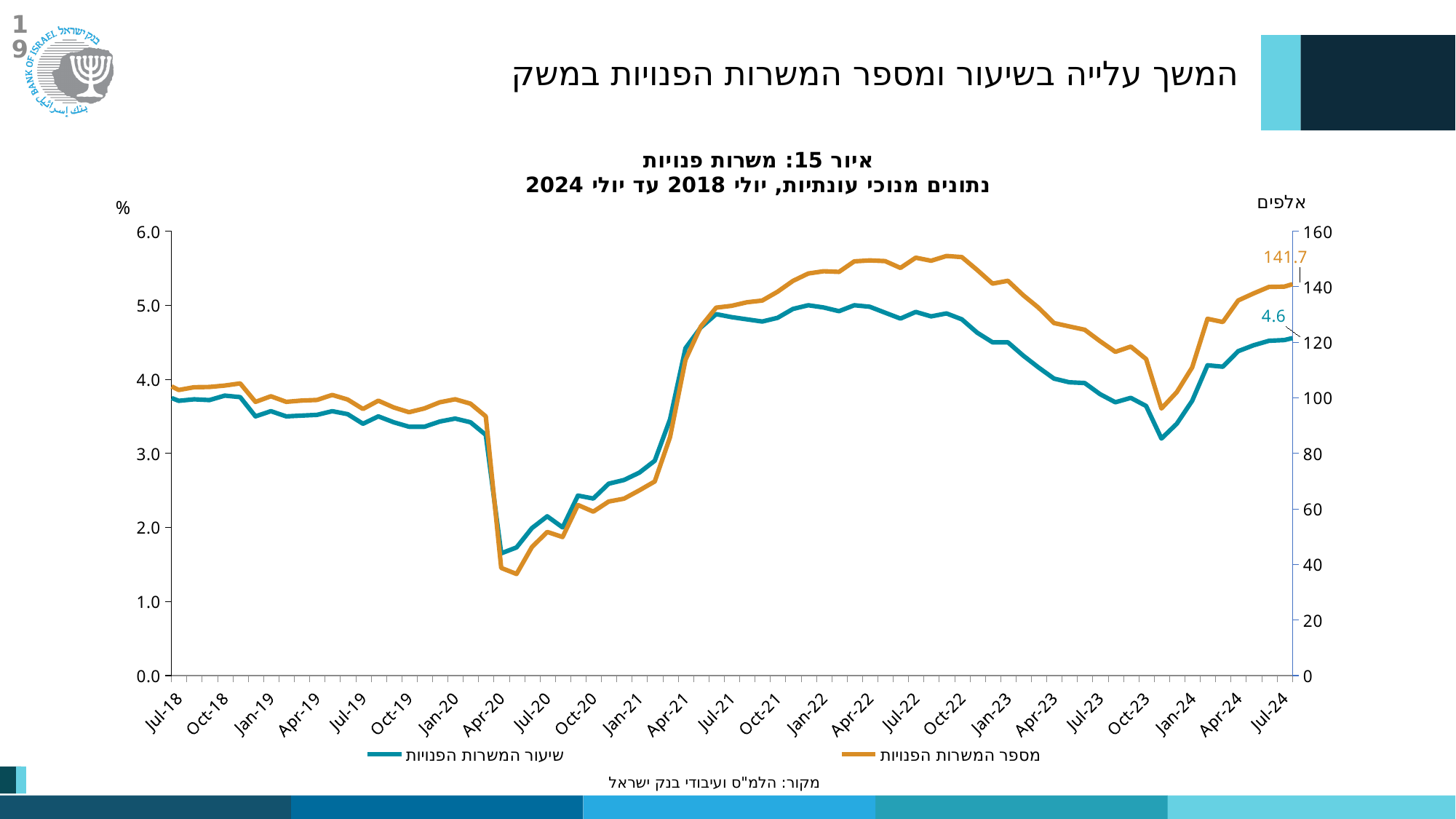
Is the number of job vacancies (מספר המשרות הפנויות) in Jul-21 greater or less than 120? greater What is the labelled value of the job vacancy rate (שיעור המשרות הפנויות) in Jul-24? 4.6 What unit is shown on the left vertical axis? % Is the job vacancy rate (שיעור המשרות הפנויות) in Apr-20 greater or less than 2.0? less Is the number of job vacancies (מספר המשרות הפנויות) in Apr-22 greater or less than 140? greater Between Oct-23 and Jul-24, does the job vacancy rate (שיעור המשרות הפנויות) rise or fall? rise What kind of chart is shown on the slide? Line chart How many series does the legend list? 2 Between Oct-22 and Oct-23, does the number of job vacancies (מספר המשרות הפנויות) rise or fall? fall What is the title of the chart? איור 15: משרות פנויות What is the labelled value of the number of job vacancies (מספר המשרות הפנויות) in Jul-24? 141.7